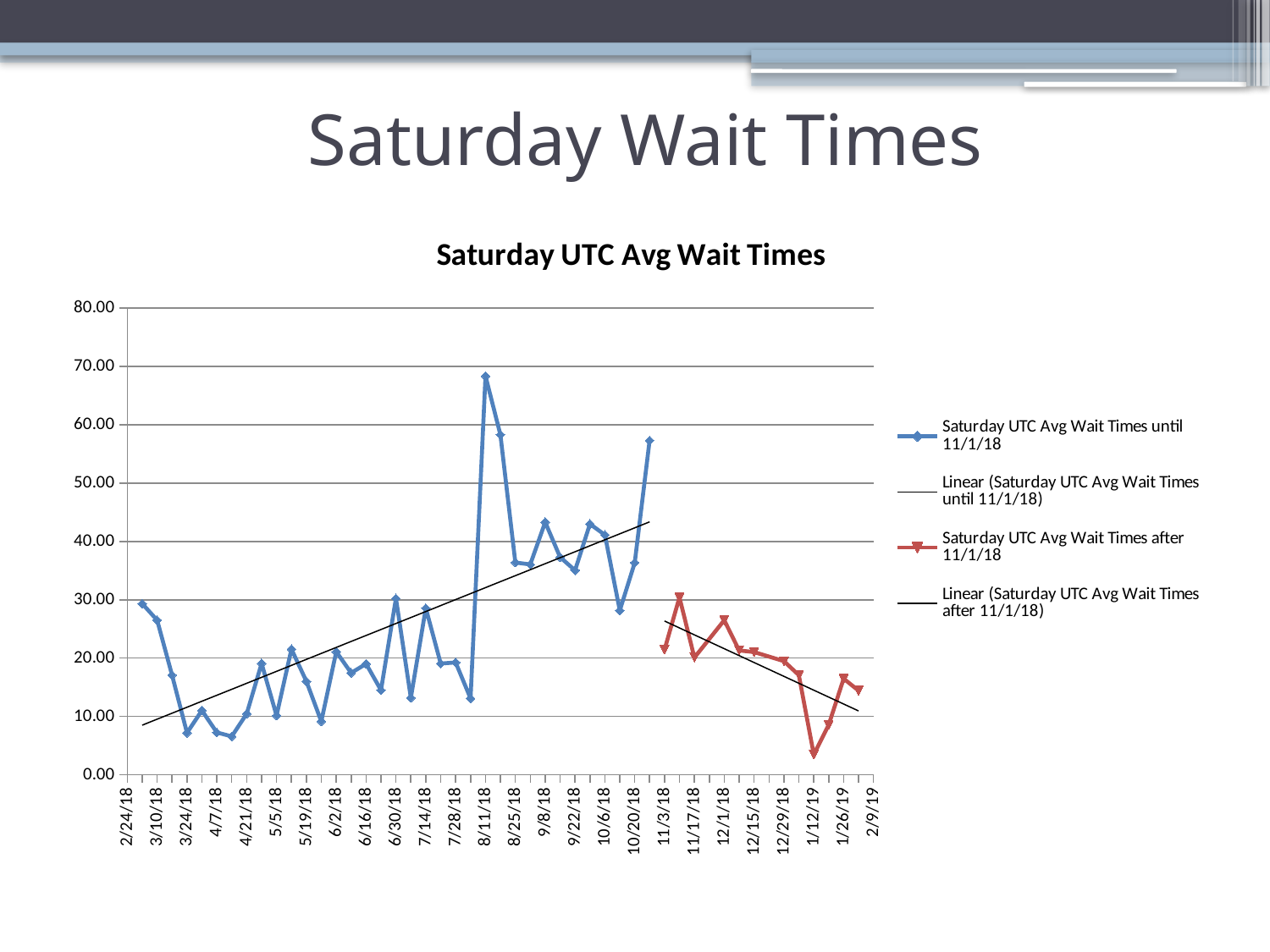
Is the value for 8/11/18 greater or less than 60? greater Is the value for 3/24/18 greater or less than 10? less Is the value for 10/20/18 greater or less than 50? less Does the linear trend line for the 'after 11/1/18' series rise or fall along the x axis? Fall At which date does the 'Saturday UTC Avg Wait Times until 11/1/18' series reach its highest value? 8/11/18 How many entries does the chart's legend list? 4 What is the title of the chart? Saturday UTC Avg Wait Times What colour is the line for 'Saturday UTC Avg Wait Times after 11/1/18'? Red What kind of chart is shown on the slide? Line chart At which date does the 'Saturday UTC Avg Wait Times after 11/1/18' series reach its lowest value? 1/12/19